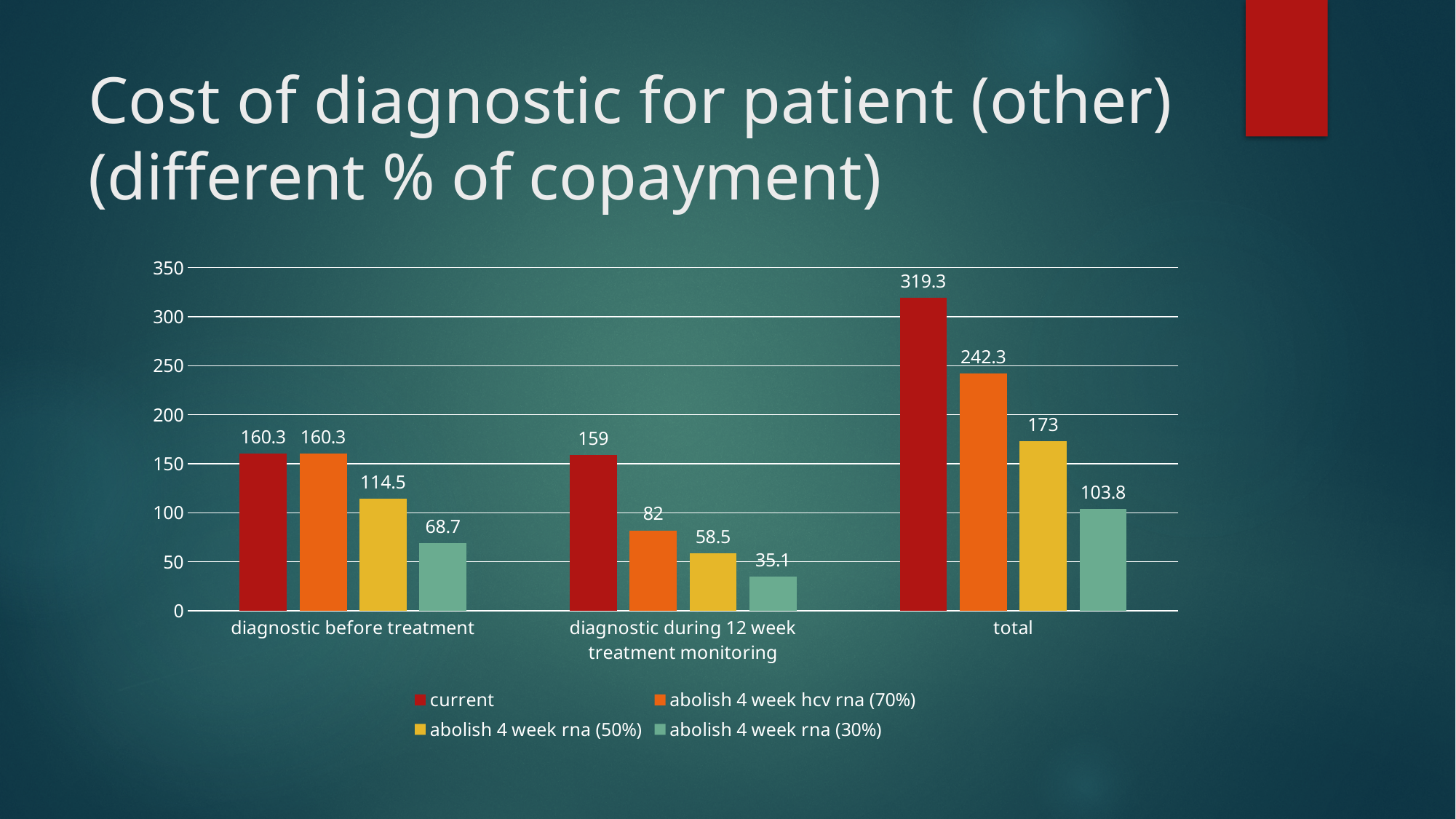
What is the value for "abolish 4 week rna (30%)" in the "diagnostic before treatment" category? 68.7 What is the difference between the "abolish 4 week rna (50%)" and "abolish 4 week rna (30%)" values in the "total" category? 69.2 Which series has the highest value in the "total" category? current Which series has the lowest value in the "diagnostic during 12 week treatment monitoring" category? abolish 4 week rna (30%) How many series does the legend list? 4 How many categories are shown on the x axis? 3 What kind of chart is shown on the slide? bar chart Which is larger: the "abolish 4 week rna (50%)" value for "diagnostic before treatment" or the "abolish 4 week rna (30%)" value for "total"? abolish 4 week rna (50%) for diagnostic before treatment What is the difference between the "current" and "abolish 4 week hcv rna (70%)" values in the "total" category? 77 What is the value for "abolish 4 week hcv rna (70%)" in the "diagnostic during 12 week treatment monitoring" category? 82 What is the value for "abolish 4 week rna (50%)" in the "total" category? 173 What is the value for "current" in the "total" category? 319.3